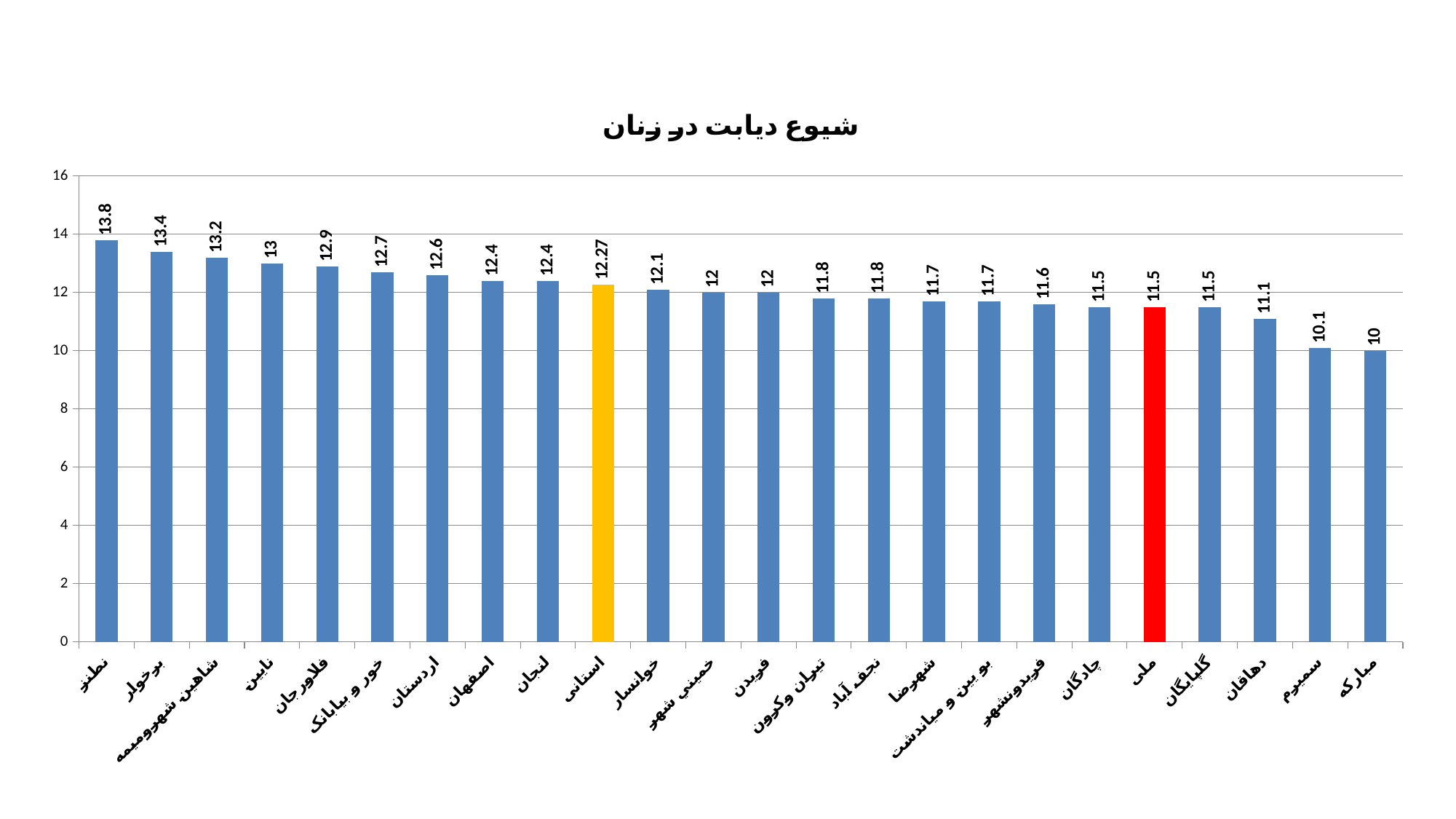
What is the title of the chart? شیوع دیابت در زنان What is the difference between the values for نطنز and مبارکه? 3.8 Which is larger, the value for برخوار or the value for دهاقان? برخوار What is the value for استانی (the yellow bar)? 12.27 What is the value for نطنز? 13.8 What kind of chart is this? Bar chart What is the value for مبارکه? 10 Which category has the lowest value? مبارکه What is the value for ملی (the red bar)? 11.5 Which category has the highest value? نطنز How many categories are shown on the x axis? 24 What is the difference between the values for استانی and ملی? 0.77